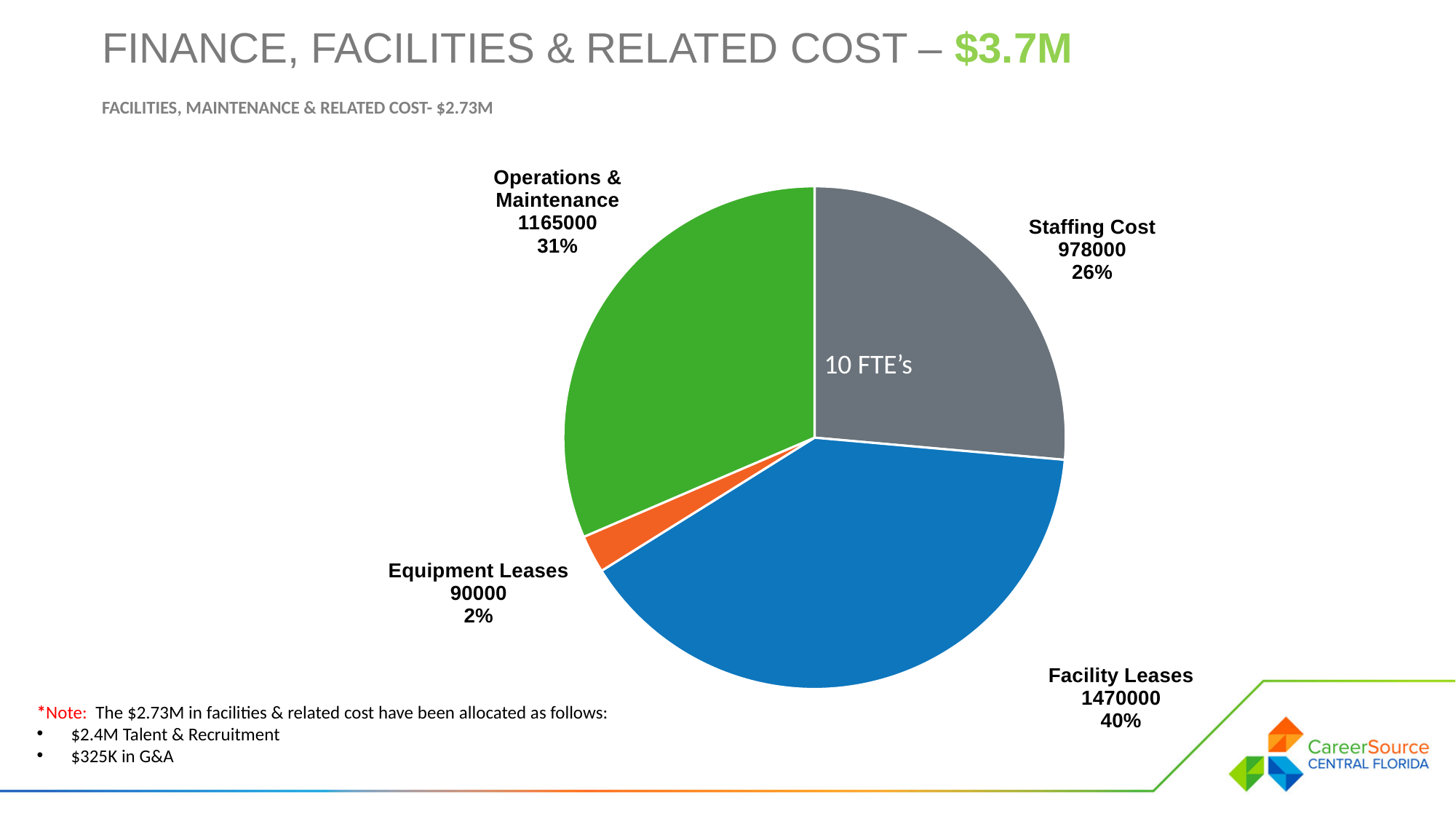
What percentage share does Facility Leases have? 40% Which category has the largest slice? Facility Leases How many slices does the pie chart have? 4 What is the value for Equipment Leases? 90000 What text is shown in the centre of the pie chart? 10 FTE's Which is larger, Operations & Maintenance or Staffing Cost? Operations & Maintenance What is the value for Staffing Cost? 978000 Which category has the smallest slice? Equipment Leases What is the value for Facility Leases? 1470000 What percentage share does Operations & Maintenance have? 31% What is the difference between the Facility Leases value and the Staffing Cost value? 492000 What type of chart is shown on the slide? pie chart